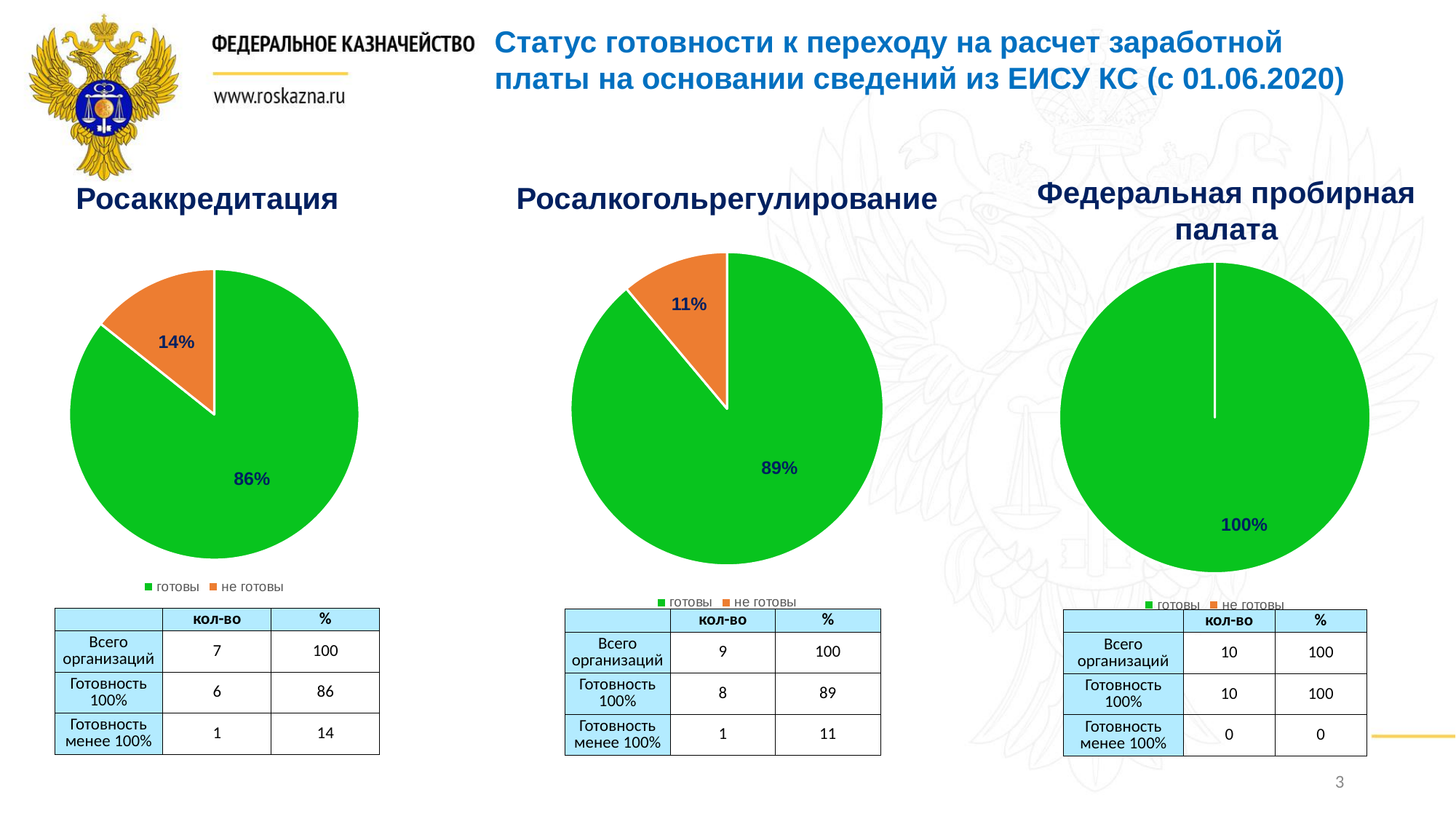
In the Росалкогольрегулирование chart, what colour is the не готовы slice? Orange In the Росалкогольрегулирование chart, which slice is the smallest? не готовы In the Росаккредитация chart, what share of the pie is labelled готовы? 86% In the Росалкогольрегулирование chart, what share of the pie is labelled готовы? 89% In the Росаккредитация chart, what share of the pie is labelled не готовы? 14% In the Росалкогольрегулирование chart, is the готовы slice larger or smaller than the не готовы slice? Larger What kind of chart is used for Росаккредитация? Pie chart How many entries does the legend of the Росаккредитация chart list? 2 In the Росаккредитация chart, what is the difference in percentage points between the готовы and не готовы slices? 72 In the Росаккредитация chart, which slice is the largest? готовы